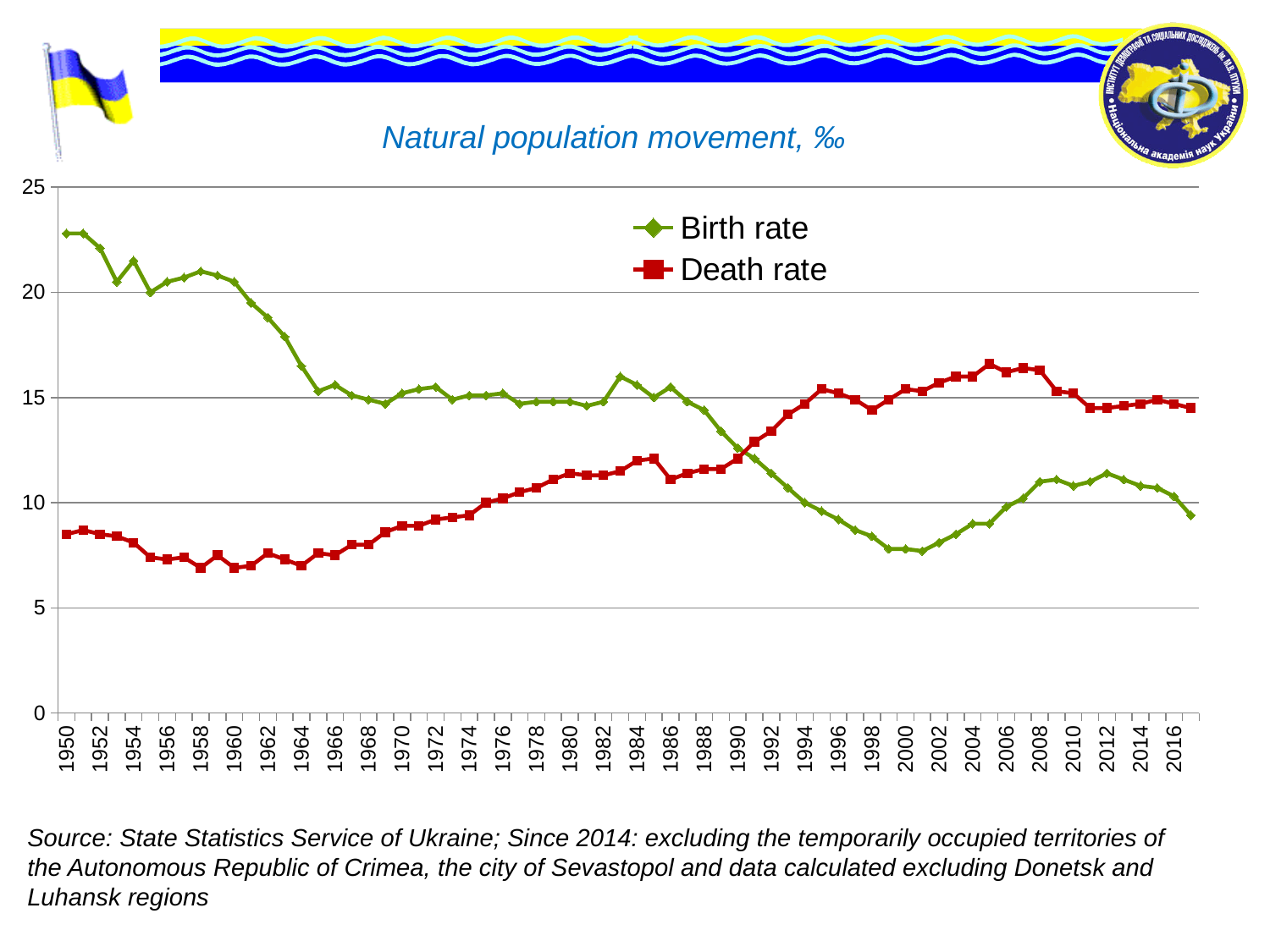
Is the Birth rate value for 2000 greater or less than 10? less In 2000, which series has the higher value, Birth rate or Death rate? Death rate Does the Birth rate rise or fall between 1950 and 1965? Fall What are the two series named in the legend? Birth rate and Death rate Is the Death rate value for 2005 greater or less than 15? greater Is the Birth rate value for 1950 greater or less than 20? greater In 1950, which series has the higher value, Birth rate or Death rate? Birth rate What kind of chart is shown on the slide? Line chart What is the title of the chart? Natural population movement, ‰ How many series does the legend list? 2 Does the Death rate rise or fall between 1960 and 1995? Rise